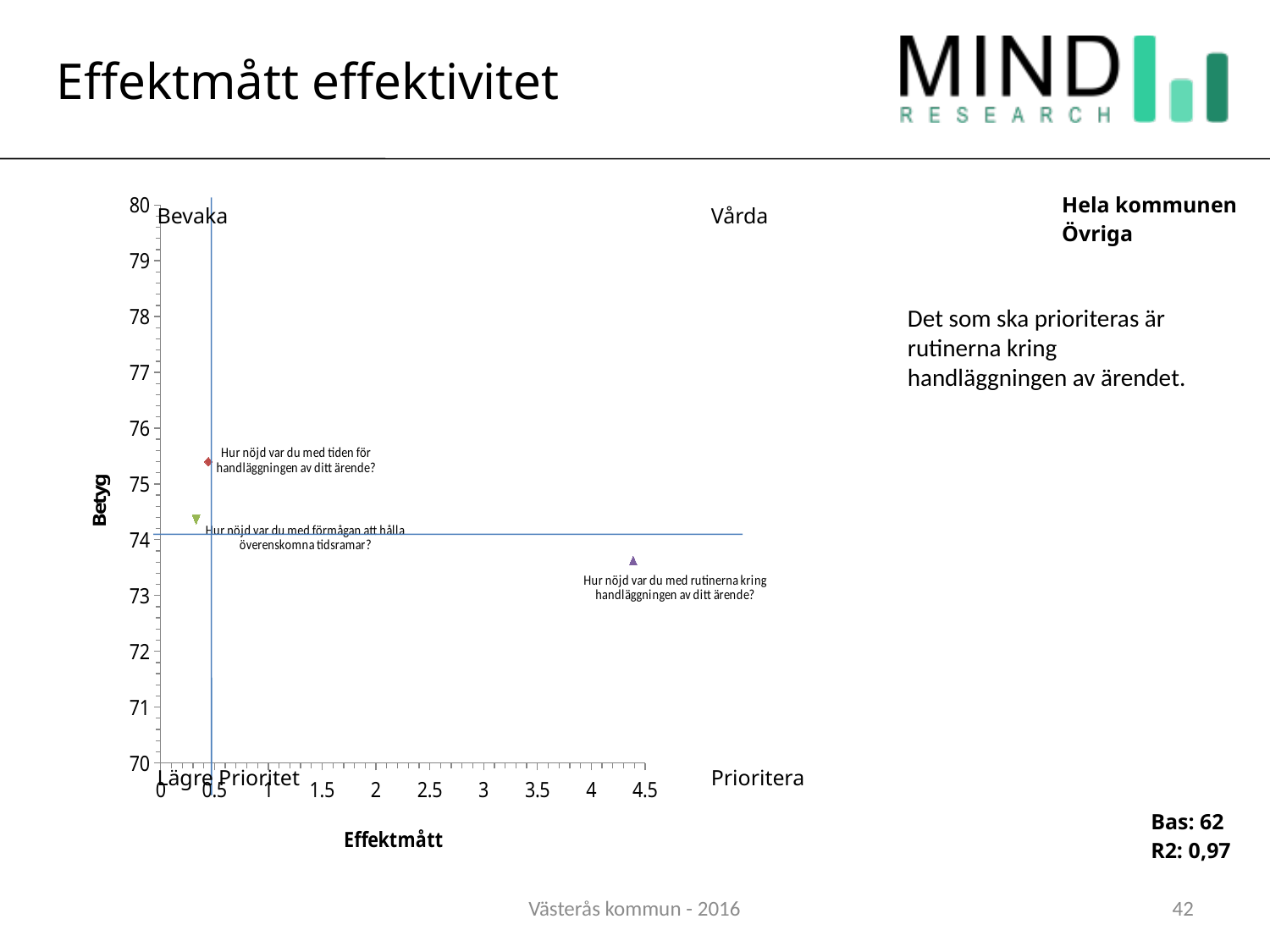
Is the Effektmått value for 'Hur nöjd var du med förmågan att hålla överenskomna tidsramar?' greater or less than 1? less What kind of chart is shown on the slide? scatter chart Is the Effektmått value for 'Hur nöjd var du med rutinerna kring handläggningen av ditt ärende?' greater or less than 4? greater Which question has the highest Betyg value in the chart? Hur nöjd var du med tiden för handläggningen av ditt ärende? What is the title of the vertical axis of the chart? Betyg Which has a higher Betyg value: 'Hur nöjd var du med tiden för handläggningen av ditt ärende?' or 'Hur nöjd var du med rutinerna kring handläggningen av ditt ärende?' Hur nöjd var du med tiden för handläggningen av ditt ärende? Which question has the lowest Betyg value in the chart? Hur nöjd var du med rutinerna kring handläggningen av ditt ärende? Is the Betyg value for 'Hur nöjd var du med tiden för handläggningen av ditt ärende?' greater or less than 75? greater Which question has the highest Effektmått value in the chart? Hur nöjd var du med rutinerna kring handläggningen av ditt ärende? How many data points are plotted in the chart? 3 What is the title of the horizontal axis of the chart? Effektmått